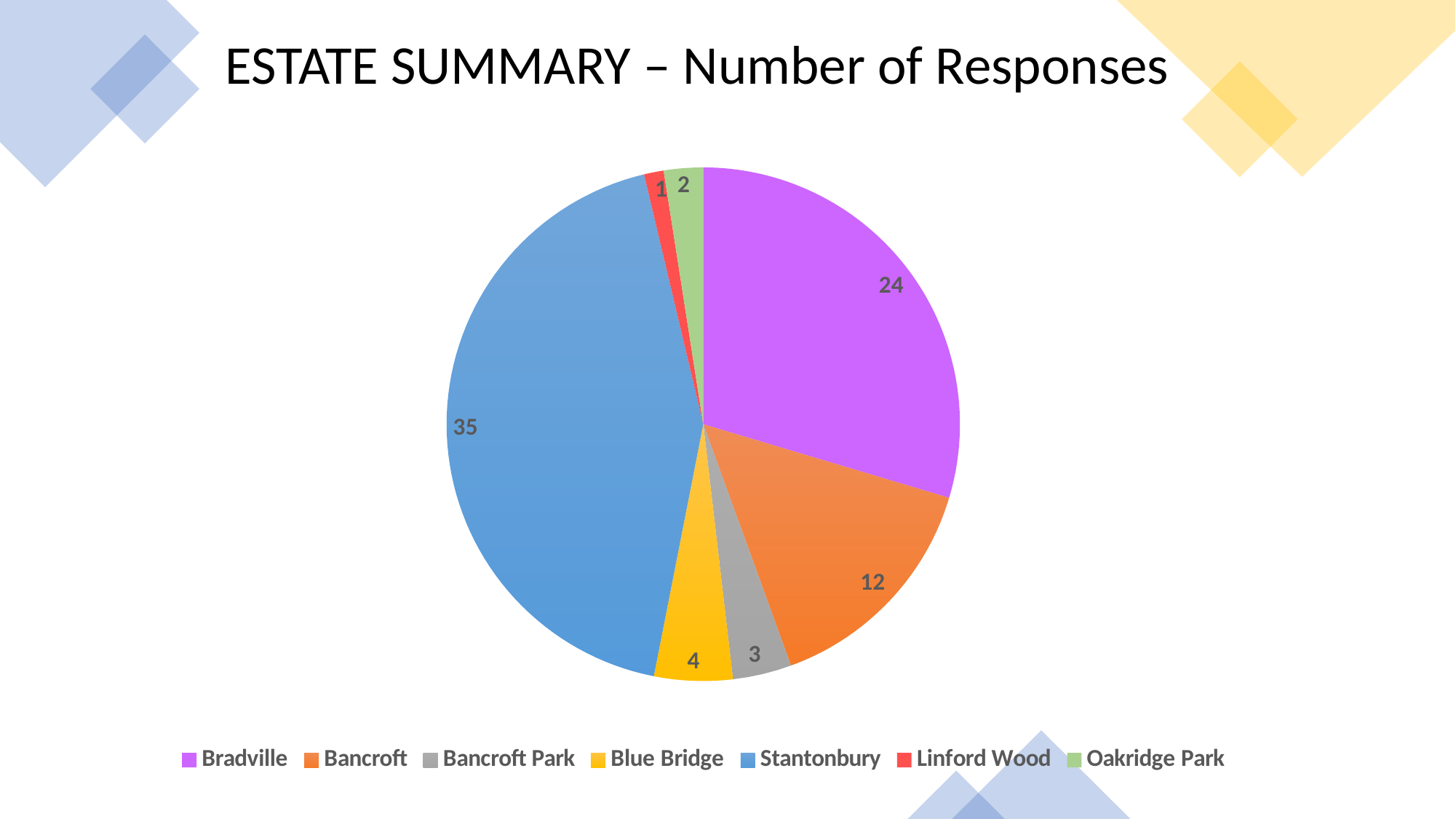
How many responses does the pie chart show for Stantonbury? 35 What is the number of responses for Bradville? 24 What type of chart is shown on the slide? Pie chart Which estate has the largest number of responses? Stantonbury Which has more responses, Blue Bridge or Oakridge Park? Blue Bridge What is the difference in responses between Bancroft and Bancroft Park? 9 What is the total number of responses across all estates in the pie chart? 81 How many responses are shown for Blue Bridge? 4 How many estates are shown in the pie chart? 7 Which estate has the smallest number of responses? Linford Wood What is the difference in responses between Stantonbury and Bradville? 11 What is the title of the chart on the slide? ESTATE SUMMARY – Number of Responses